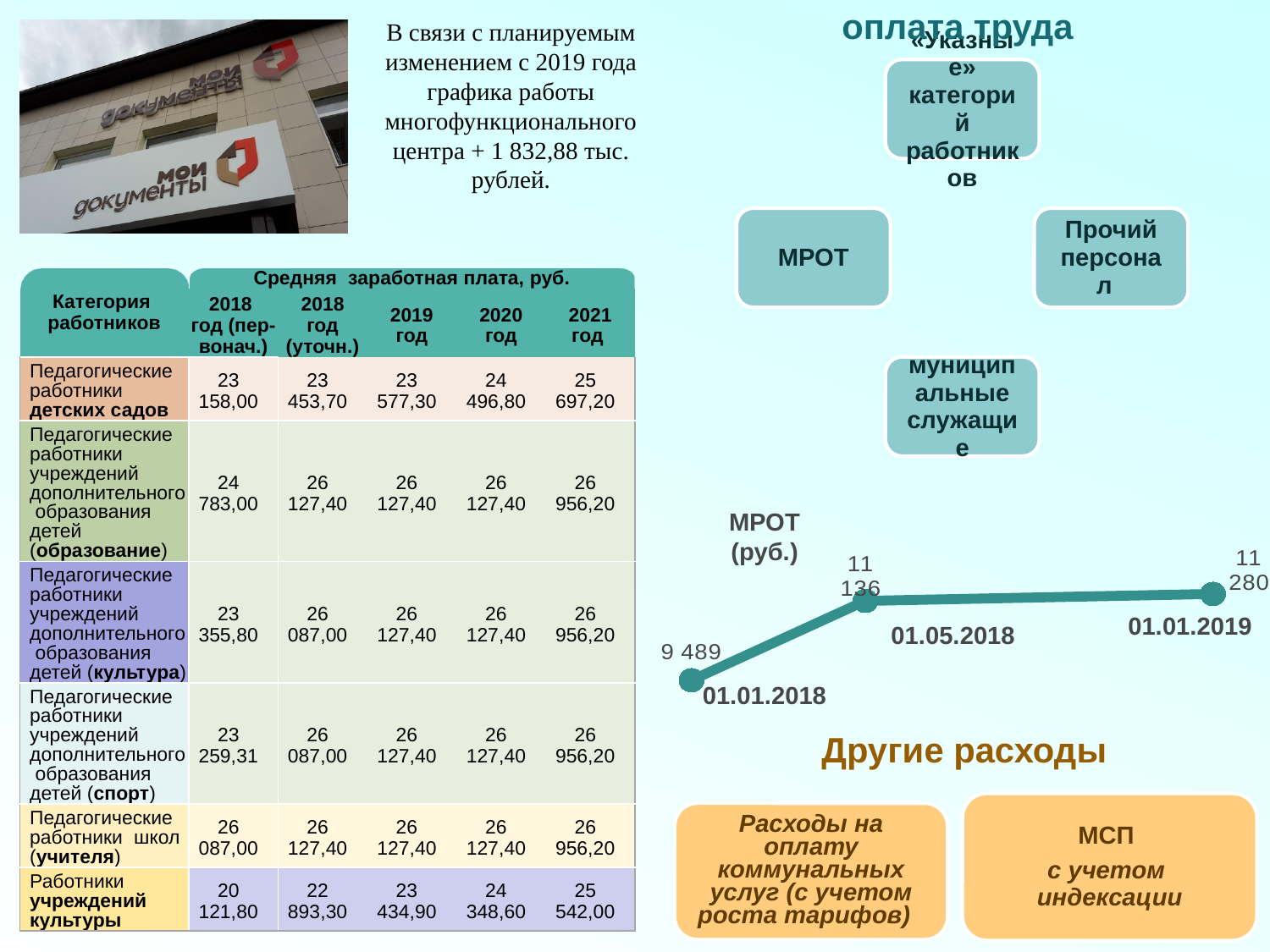
How many data points are plotted on the МРОТ (руб.) chart? 3 On the МРОТ (руб.) chart, what is the difference between the values for 01.05.2018 and 01.01.2018? 1 647 Do the values on the МРОТ (руб.) chart rise or fall from 01.01.2018 to 01.01.2019? rise Which date has the highest value on the МРОТ (руб.) chart? 01.01.2019 Which date has the lowest value on the МРОТ (руб.) chart? 01.01.2018 On the МРОТ (руб.) chart, which is larger: the value for 01.05.2018 or for 01.01.2018? 01.05.2018 On the МРОТ (руб.) chart, what is the difference between the values for 01.01.2019 and 01.01.2018? 1 791 On the МРОТ (руб.) chart, what is the difference between the values for 01.01.2019 and 01.05.2018? 144 What kind of chart is the МРОТ (руб.) chart? line chart What is the value for 01.01.2019 on the МРОТ (руб.) line chart? 11 280 What is the value for 01.05.2018 on the МРОТ (руб.) line chart? 11 136 What is the value for 01.01.2018 on the МРОТ (руб.) line chart? 9 489